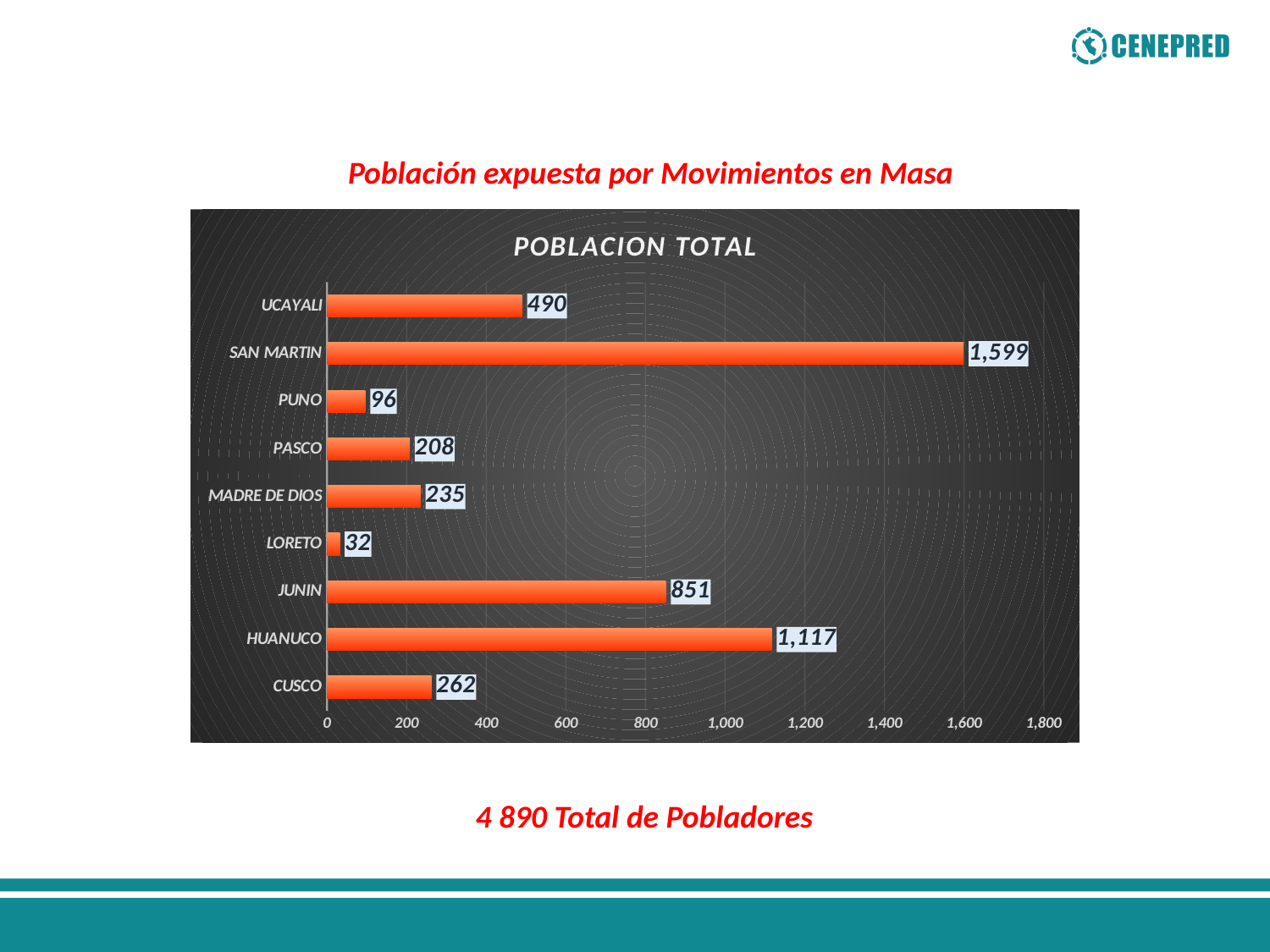
What kind of chart is shown? bar chart What is the value for HUANUCO? 1,117 What is the title of the chart? POBLACION TOTAL How many categories are shown in the chart? 9 What is the value for MADRE DE DIOS? 235 What is the difference between the values for SAN MARTIN and HUANUCO? 482 Is the value for CUSCO greater or less than 400? less What is the value for LORETO? 32 What is the value for SAN MARTIN? 1,599 Which category has the lowest value? LORETO Which is larger, the value for JUNIN or the value for UCAYALI? JUNIN Which category has the highest value? SAN MARTIN